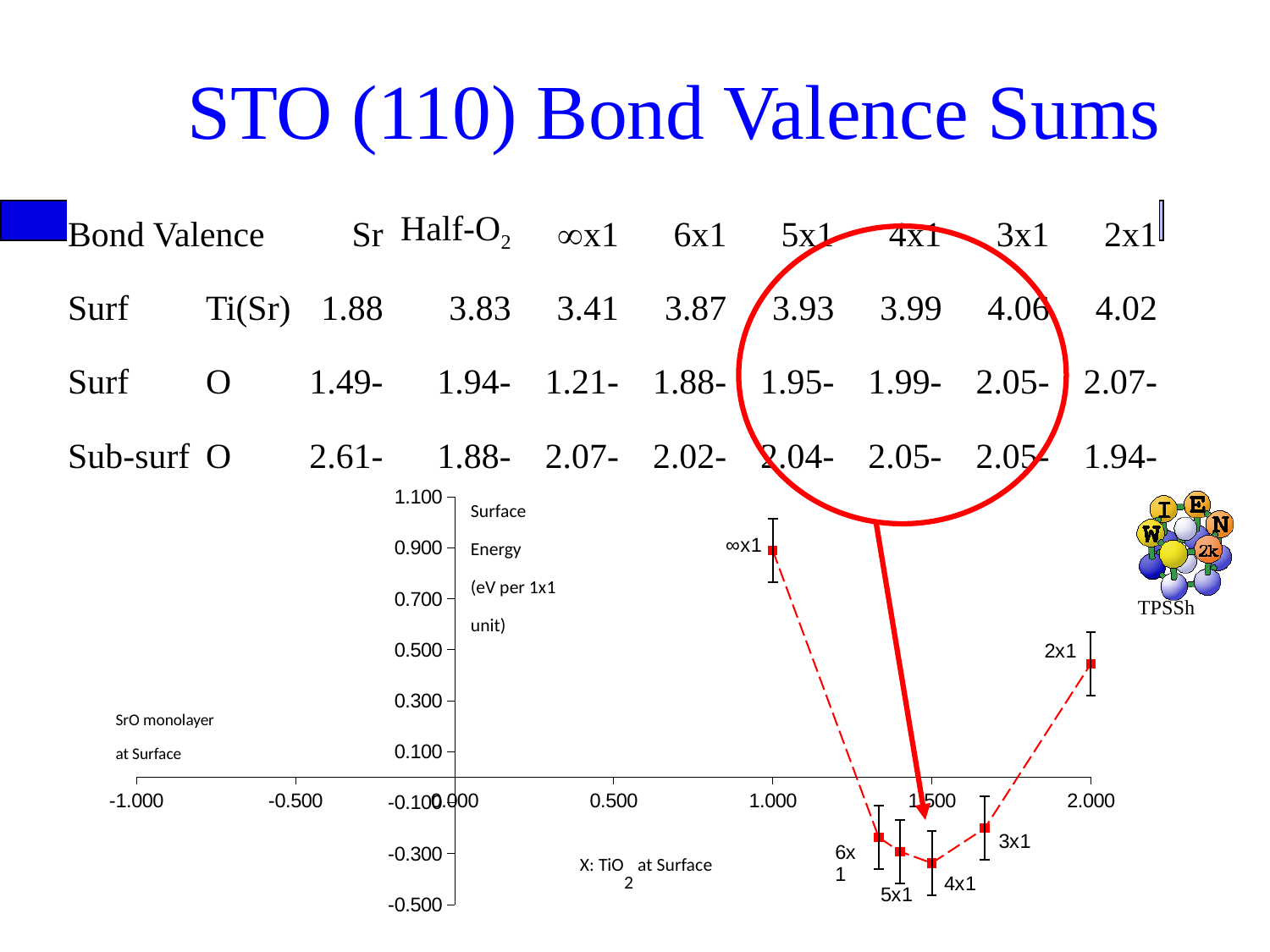
Which labelled point has the highest surface energy? ∞x1 Which labelled point has the lowest surface energy? 4x1 At what x-axis value is the 4x1 point plotted? 1.500 Which has the higher surface energy, 3x1 or 2x1? 2x1 Is the surface energy for 2x1 greater or less than 0.300? greater How many data points are plotted in the surface energy chart? 6 Is the surface energy for 4x1 greater or less than -0.100? less Which has the higher surface energy, ∞x1 or 2x1? ∞x1 What kind of chart is shown at the bottom of the slide? scatter chart Does the surface energy rise or fall going from ∞x1 to 4x1 along the x axis? fall What is the label on the x axis of the chart? X: TiO2 at Surface Is the surface energy for ∞x1 greater or less than 0.700? greater